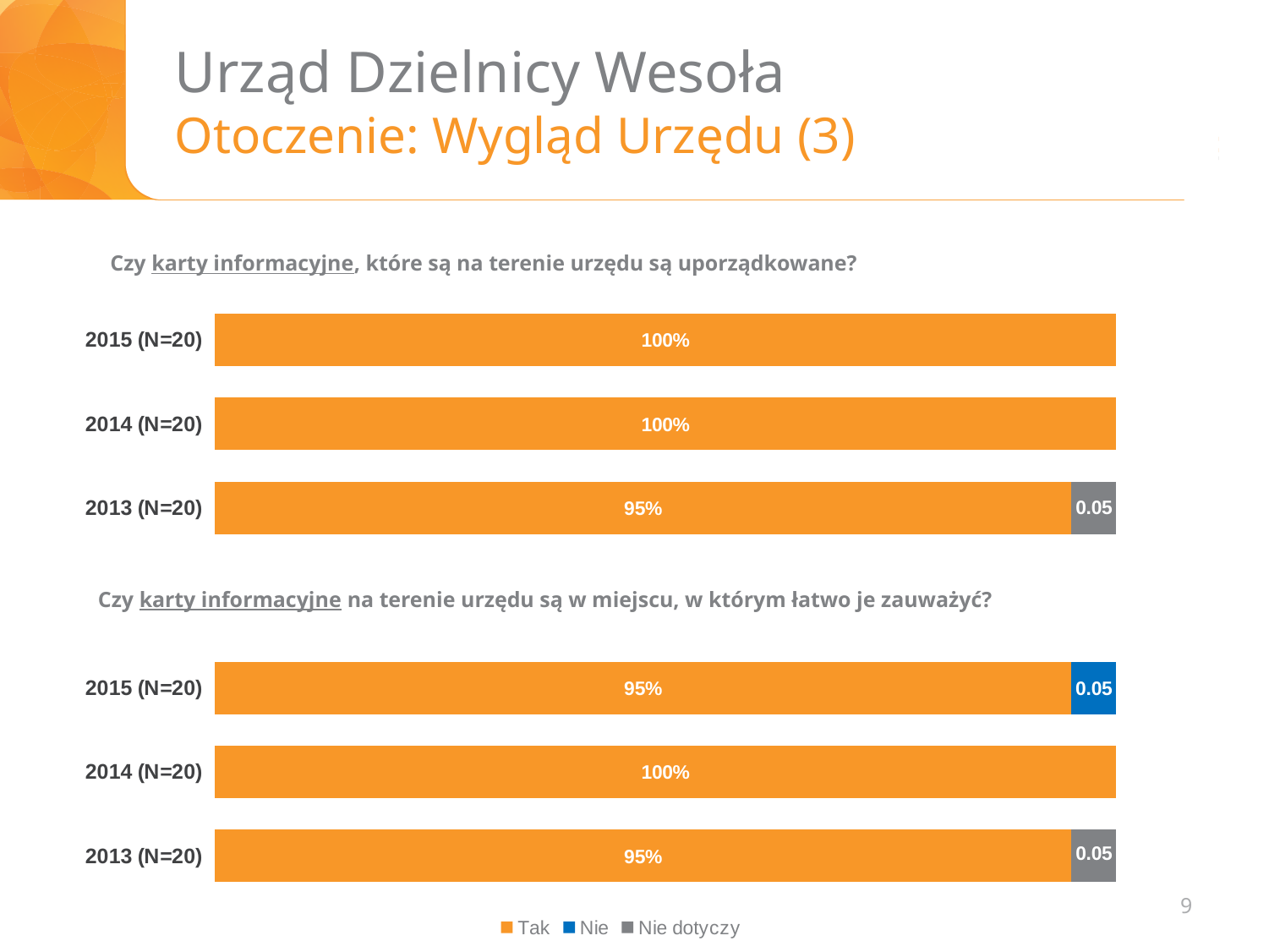
In the bottom chart, what is the 'Tak' value for 2015 (N=20)? 95% How many series does the legend at the bottom of the slide list? 3 In the bottom chart, is the 'Tak' value for 2015 (N=20) larger or smaller than for 2014 (N=20)? smaller In the bottom chart, what value is shown for the 'Nie' segment in 2015 (N=20)? 0.05 In the top chart, which year has the lowest 'Tak' value? 2013 (N=20) In the bottom chart, which year has the highest 'Tak' value? 2014 (N=20) What type of chart is the bottom chart? bar chart How many year categories does the top chart show? 3 In the bottom chart, what is the 'Tak' value for 2014 (N=20)? 100% In the top chart, what is the 'Tak' value for 2015 (N=20)? 100% In the top chart, what is the difference between the 'Tak' value for 2014 (N=20) and 2013 (N=20)? 5% In the top chart, what is the 'Tak' value for 2013 (N=20)? 95%